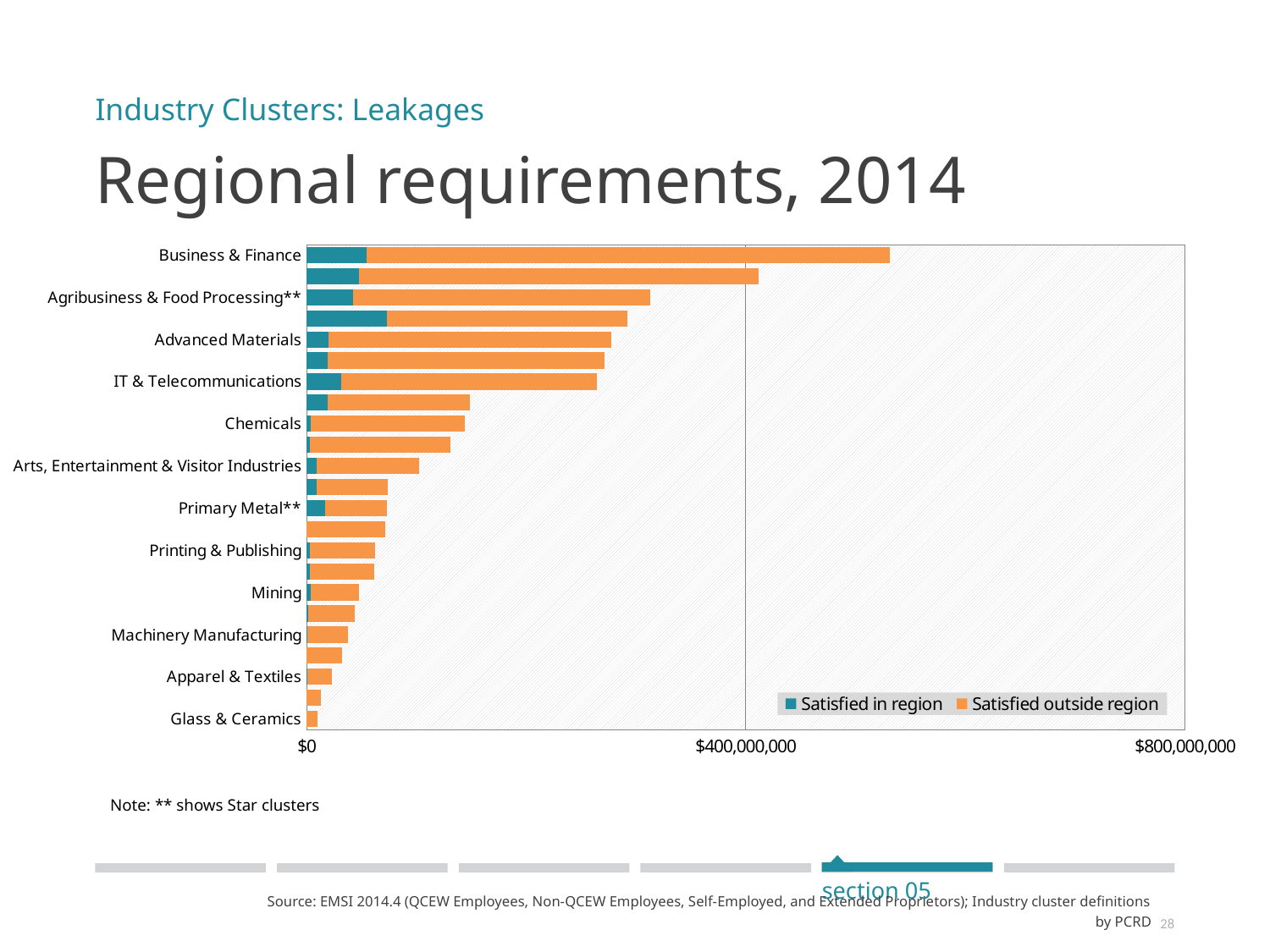
Is the total value for Business & Finance greater or less than $400,000,000? greater Which has the larger total bar, Mining or Advanced Materials? Advanced Materials What is the title of the chart on the slide? Regional requirements, 2014 Do the total bar lengths increase or decrease going from the top of the chart to the bottom? Decrease What are the two series named in the legend? Satisfied in region; Satisfied outside region Which has the larger total bar, Business & Finance or IT & Telecommunications? Business & Finance How many series does the legend list? 2 What kind of chart is shown on the slide? Bar chart Which labelled industry cluster has the longest total bar? Business & Finance Is the total value for Chemicals greater or less than $400,000,000? less Is the total value for Agribusiness & Food Processing** greater or less than $400,000,000? less Which labelled industry cluster has the shortest total bar? Glass & Ceramics